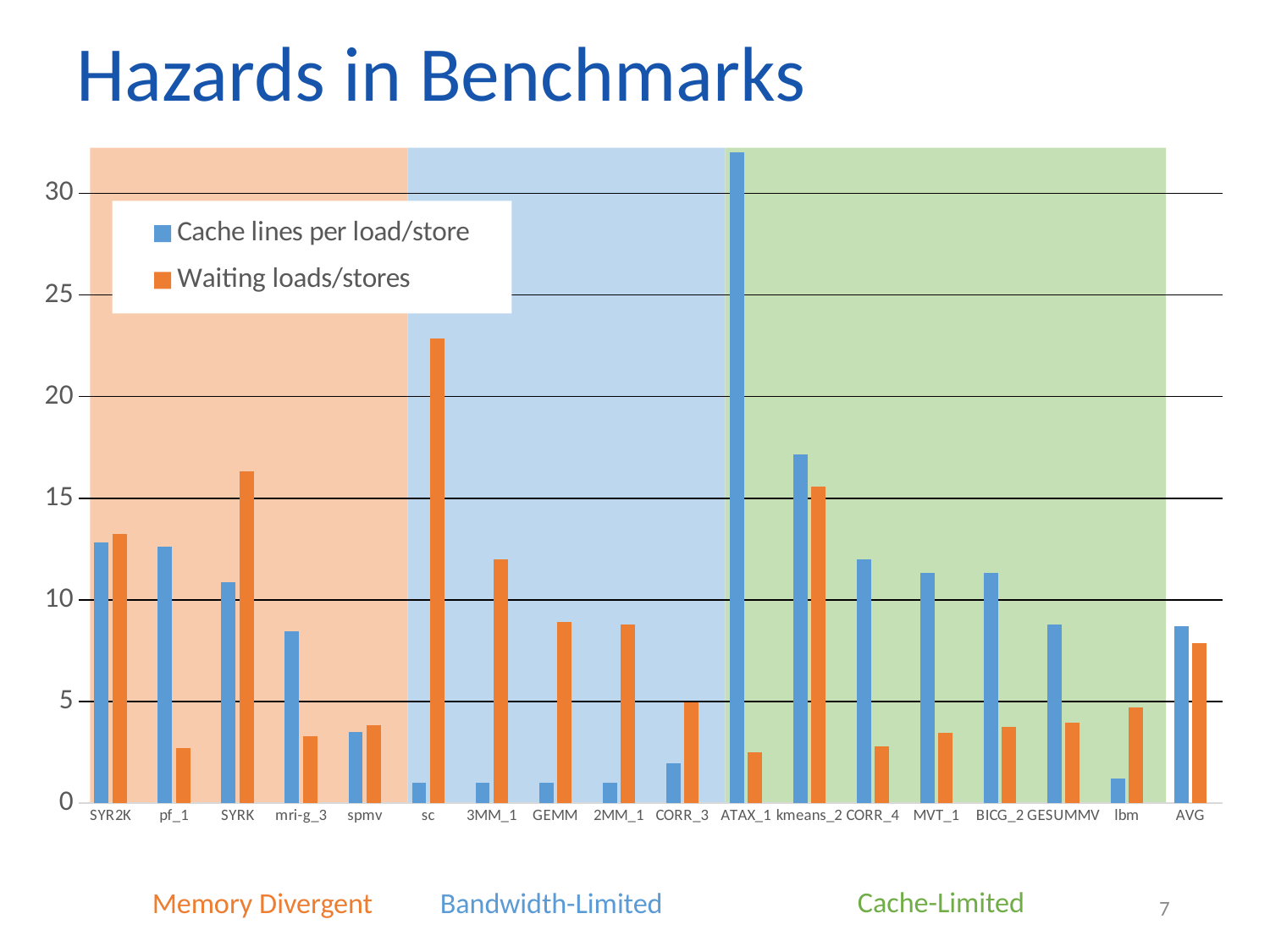
Is the Waiting loads/stores value for sc greater or less than 20? greater For GESUMMV, which is larger: Cache lines per load/store or Waiting loads/stores? Cache lines per load/store Is the Cache lines per load/store value for CORR_3 greater or less than 5? less What kind of chart is shown on the slide? bar chart How many series does the legend list? 2 How many benchmark categories are shown along the x axis, including AVG? 18 For SYRK, which is larger: Cache lines per load/store or Waiting loads/stores? Waiting loads/stores Is the Cache lines per load/store value for ATAX_1 greater or less than 30? greater Which colour represents the Waiting loads/stores series? orange Which benchmark has the highest value for Cache lines per load/store? ATAX_1 Which benchmark has the highest value for Waiting loads/stores? sc